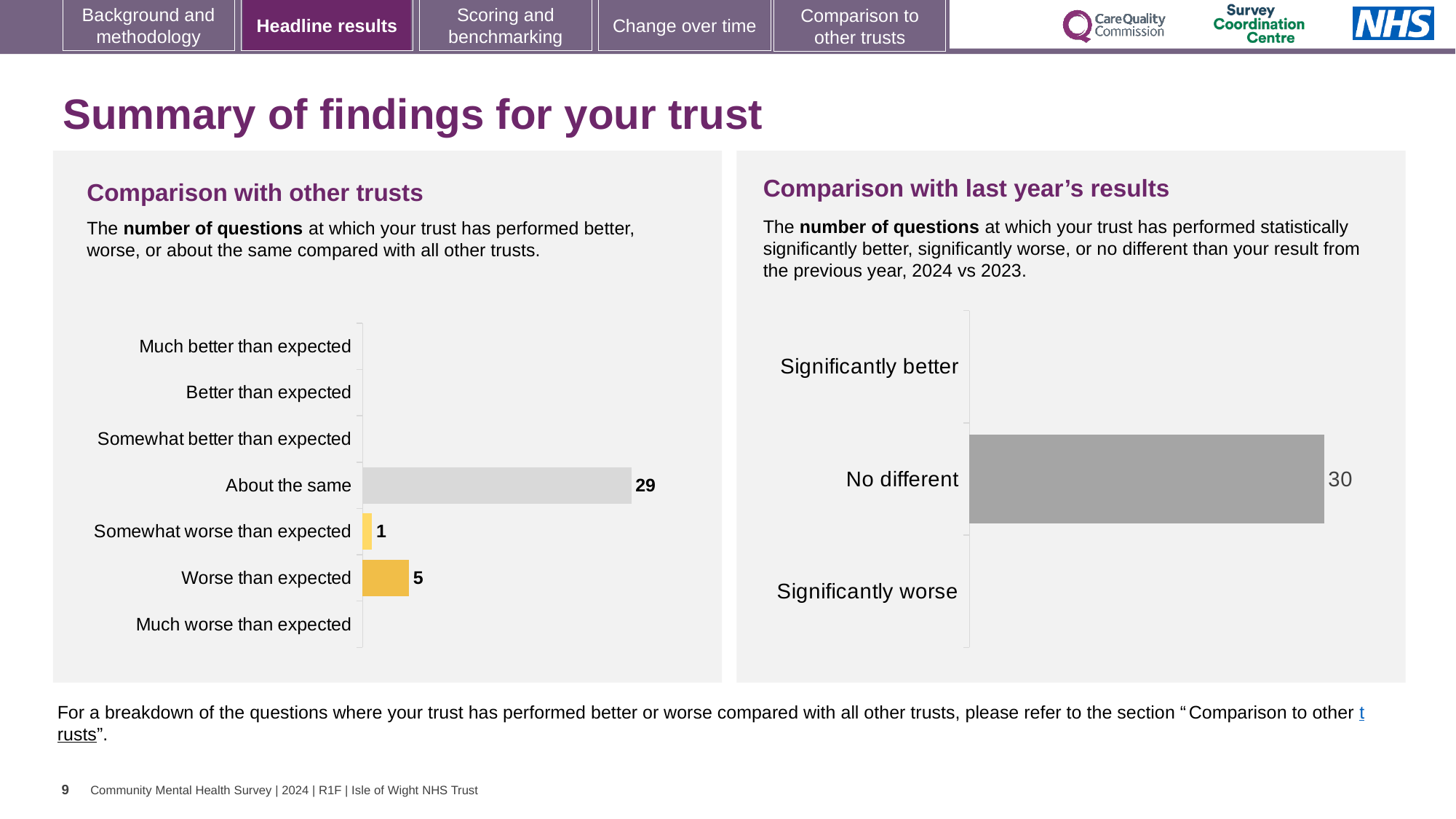
In the 'Comparison with other trusts' chart, what is the value for 'Somewhat worse than expected'? 1 In the 'Comparison with last year's results' chart, what is the value for 'No different'? 30 How many categories are listed on the axis of the 'Comparison with last year's results' chart? 3 In the 'Comparison with other trusts' chart, which category has the highest value? About the same In the 'Comparison with other trusts' chart, what is the difference between 'About the same' and 'Worse than expected'? 24 In the 'Comparison with last year's results' chart, which category has the highest value? No different In the 'Comparison with other trusts' chart, what is the value for 'Worse than expected'? 5 In the 'Comparison with other trusts' chart, how many questions are 'About the same'? 29 In the 'Comparison with other trusts' chart, which is larger: 'Worse than expected' or 'Somewhat worse than expected'? Worse than expected What type of chart is the 'Comparison with last year's results' chart? Bar chart In the 'Comparison with other trusts' chart, what colour is the bar for 'Worse than expected'? Yellow How many categories are listed on the axis of the 'Comparison with other trusts' chart? 7